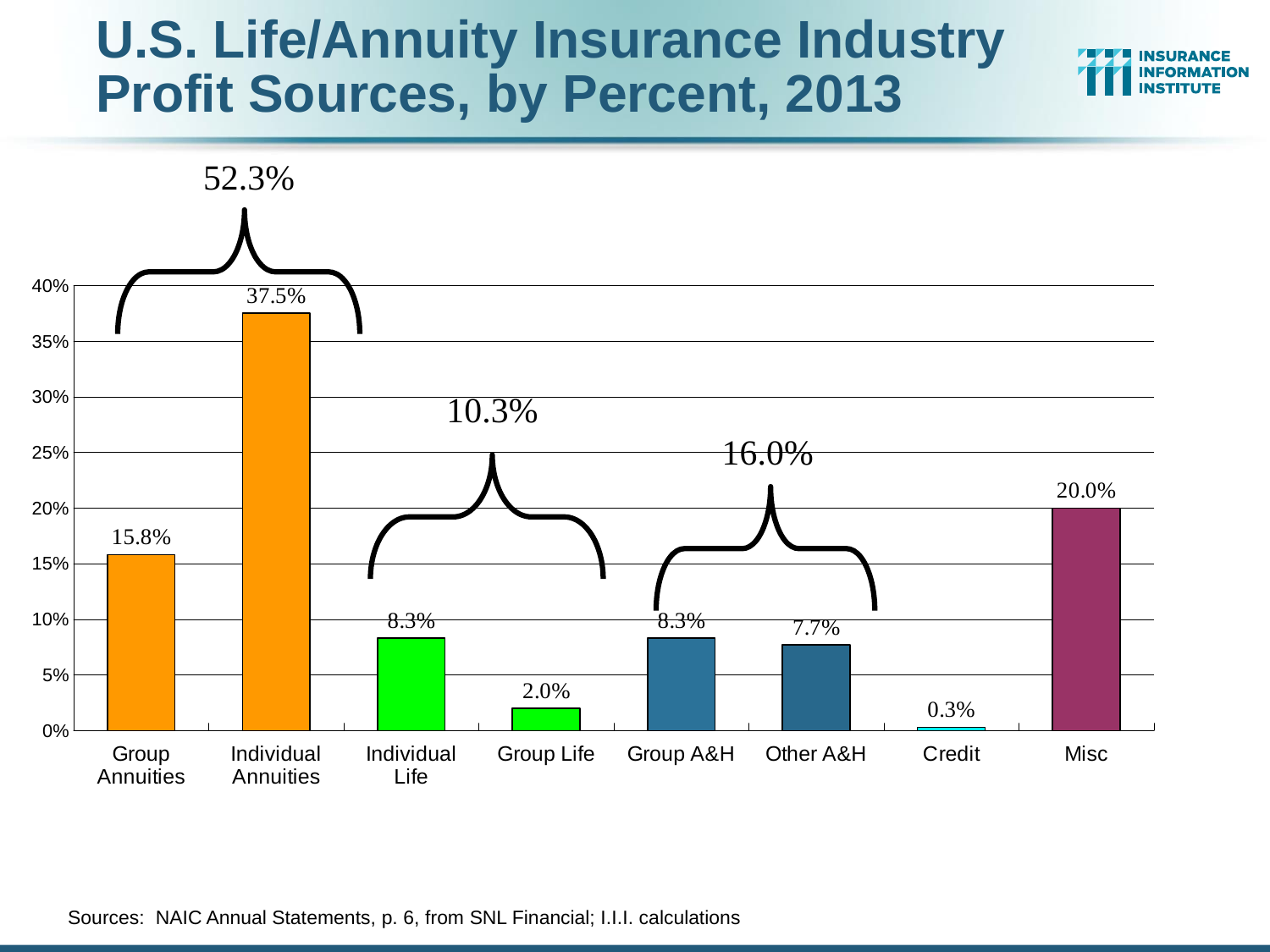
What combined percentage does the bracket over Group Annuities and Individual Annuities show? 52.3% What is the value for Misc? 20.0% What is the value for Other A&H? 7.7% What is the difference between Misc and Group Life? 18.0% What kind of chart is this? Bar chart Which is larger, Group Annuities or Misc? Misc What is the value for Credit? 0.3% What is the difference between Individual Annuities and Group Annuities? 21.7% What is the value for Individual Annuities? 37.5% How many categories are shown on the x axis? 8 Which category has the lowest value? Credit Which category has the highest value? Individual Annuities